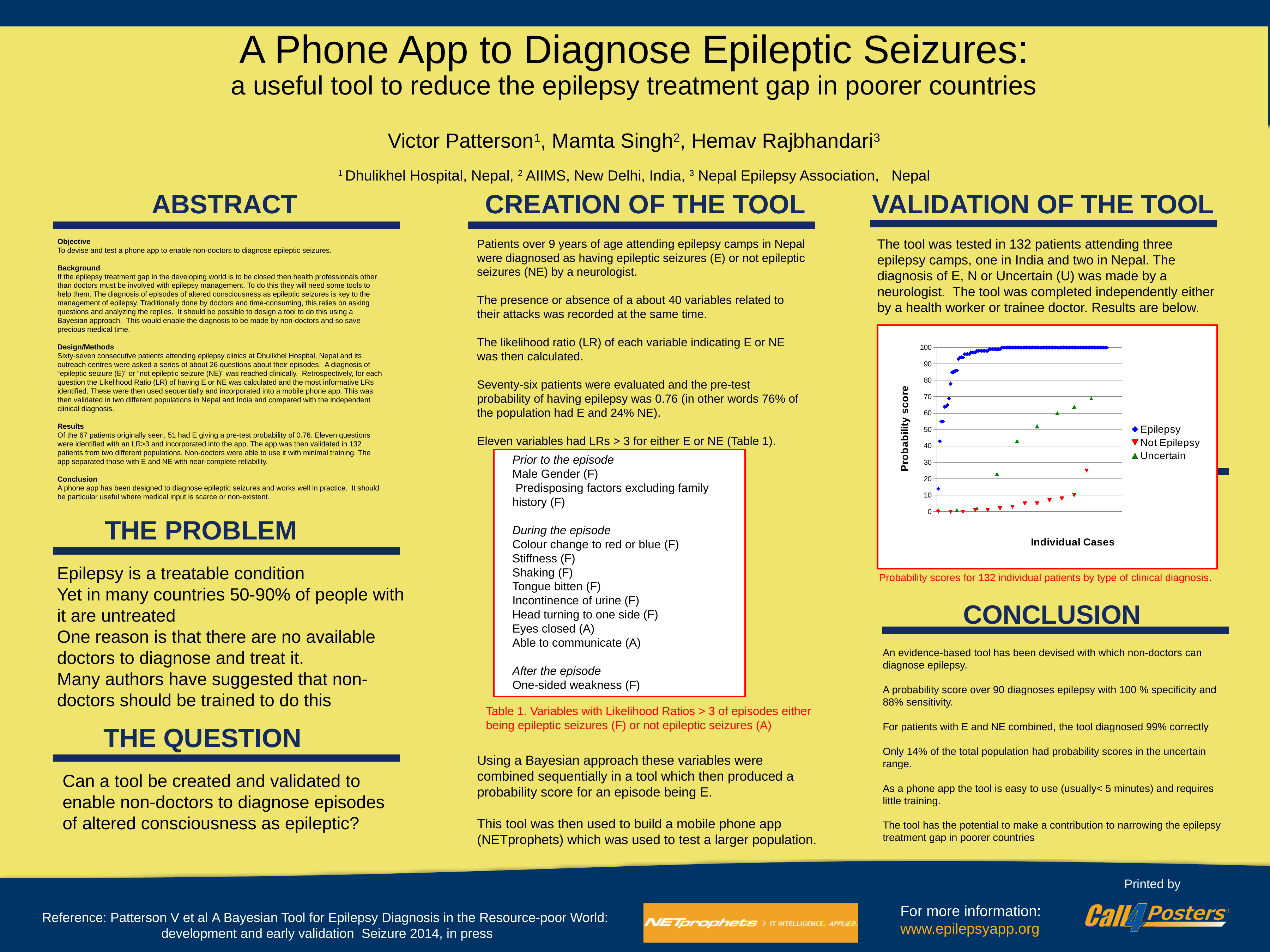
What is the title of the y axis of the probability score chart? Probability score In the probability score chart, do the Epilepsy scores rise or fall moving left to right along the x axis? rise In the probability score chart, which series has the lowest probability scores overall? Not Epilepsy According to the chart caption, how many individual patients are plotted in the probability score chart? 132 In the probability score chart, is the highest Uncertain value greater or less than 60? greater How many series does the legend of the probability score chart list? 3 In the probability score chart, is the highest Not Epilepsy value greater or less than 30? less In the probability score chart, which series reaches the highest probability scores? Epilepsy In the probability score chart, is the lowest Epilepsy value greater or less than 20? less In the probability score chart, which series has higher values: Uncertain or Not Epilepsy? Uncertain What kind of chart is shown in the Validation of the Tool section? Scatter chart What are the three series named in the legend of the probability score chart? Epilepsy, Not Epilepsy, Uncertain